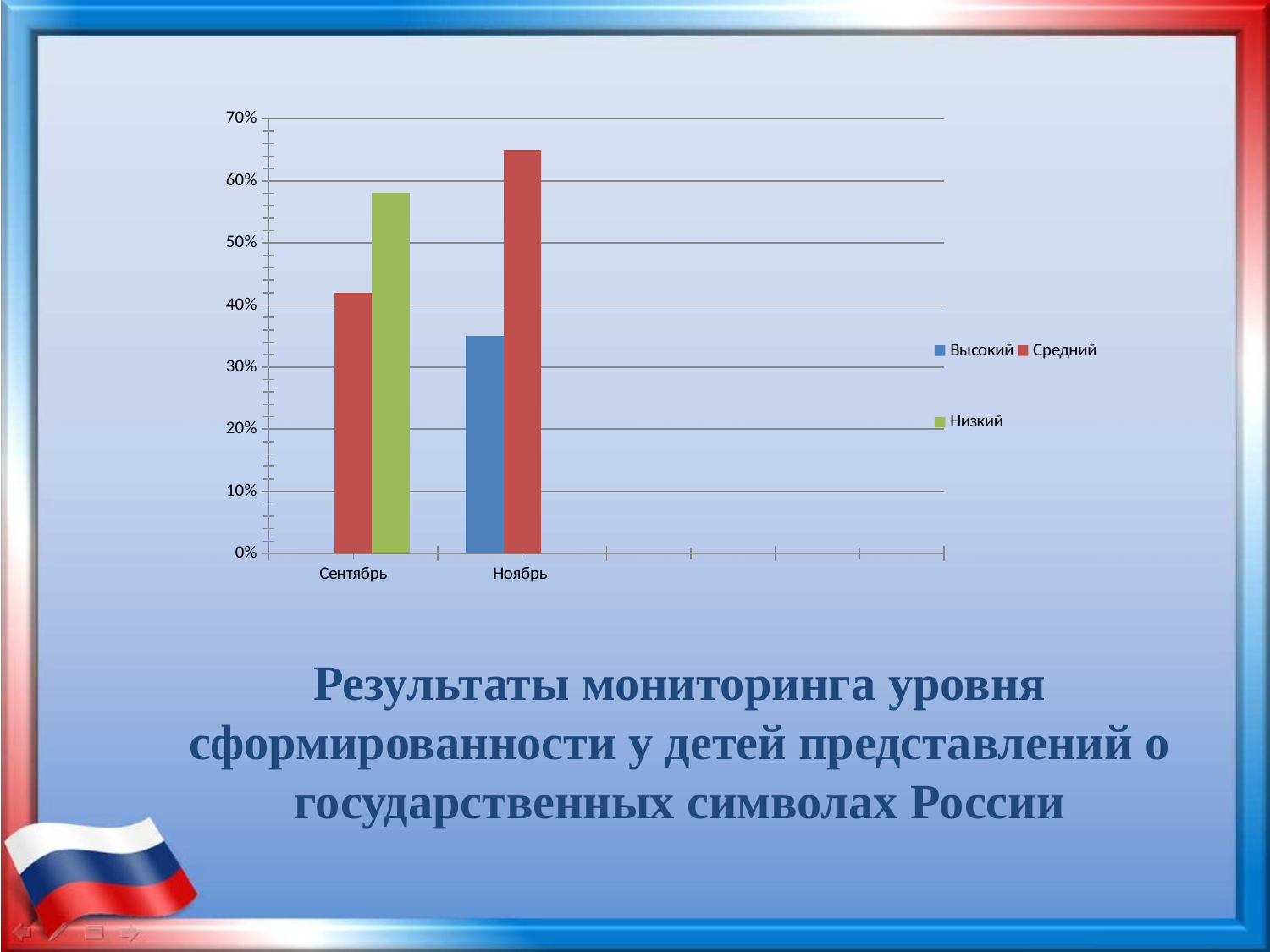
Is the value for Низкий in Сентябрь greater or less than 50%? greater What kind of chart is shown on the slide? Bar chart Which is larger: Средний in Сентябрь or Средний in Ноябрь? Средний in Ноябрь Which series has the tallest bar on the chart? Средний (Ноябрь) Does the Средний series rise or fall from Сентябрь to Ноябрь? Rises How many series does the legend list? 3 Is the value for Высокий in Ноябрь greater or less than 40%? less How many categories are shown on the x axis? 2 Which bar is the shortest on the chart? Высокий (Ноябрь) Is the value for Средний in Сентябрь greater or less than 50%? less What colour represents the Низкий series in the legend? Green